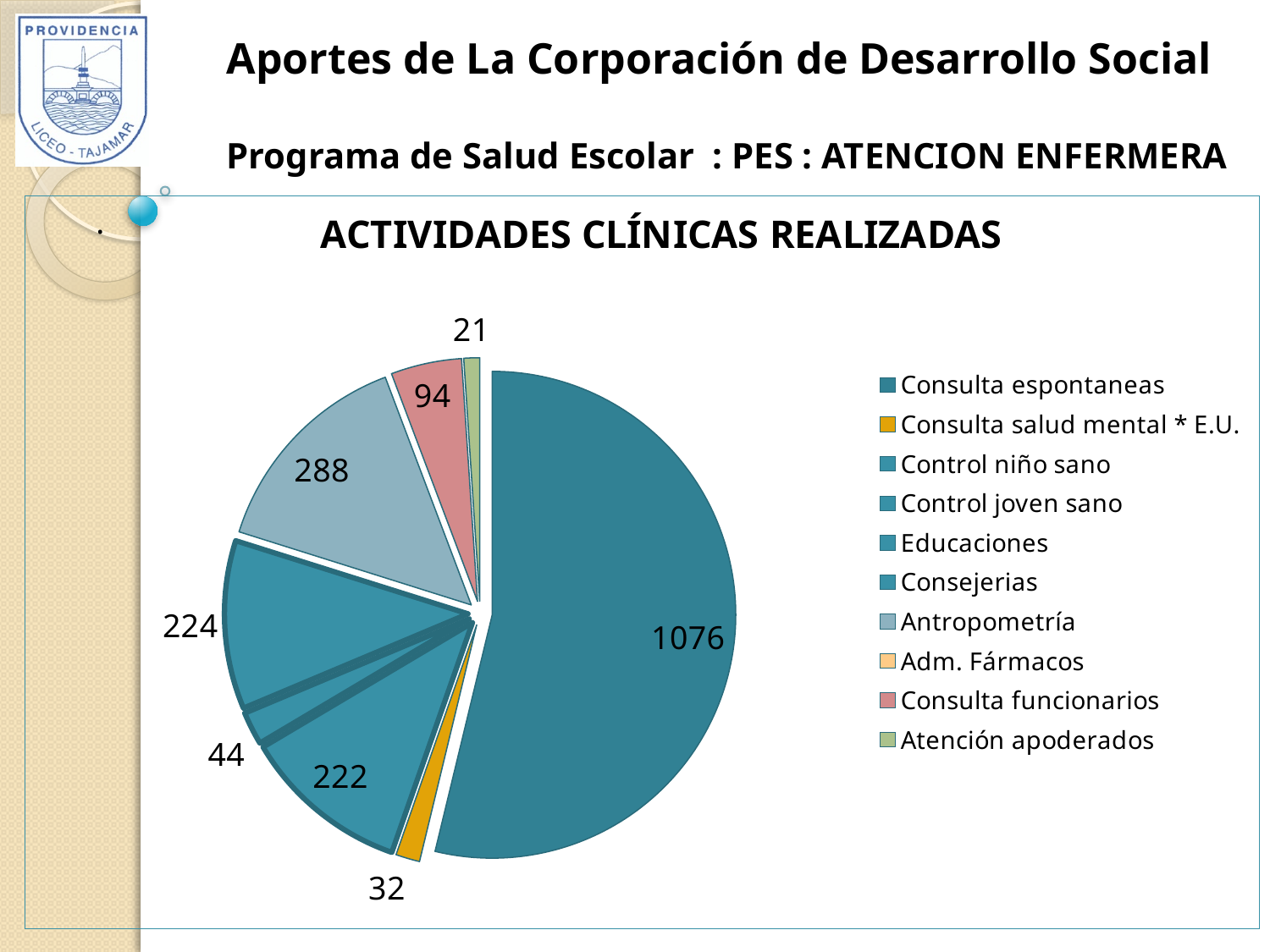
What is the value for Atención apoderados? 21 Which category has the largest slice of the pie? Consulta espontaneas What is the value for Consulta espontaneas? 1076 What is the value for Consulta funcionarios? 94 What kind of chart is shown on the slide? Pie chart Which is larger, the value for Antropometría or the value for Consulta funcionarios? Antropometría How many categories does the legend list? 10 What colour is the slice for Consulta salud mental * E.U.? Orange What is the value for Antropometría? 288 What is the value for Consulta salud mental * E.U.? 32 What is the difference between the values for Consulta espontaneas and Antropometría? 788 What is the title of the chart? ACTIVIDADES CLÍNICAS REALIZADAS